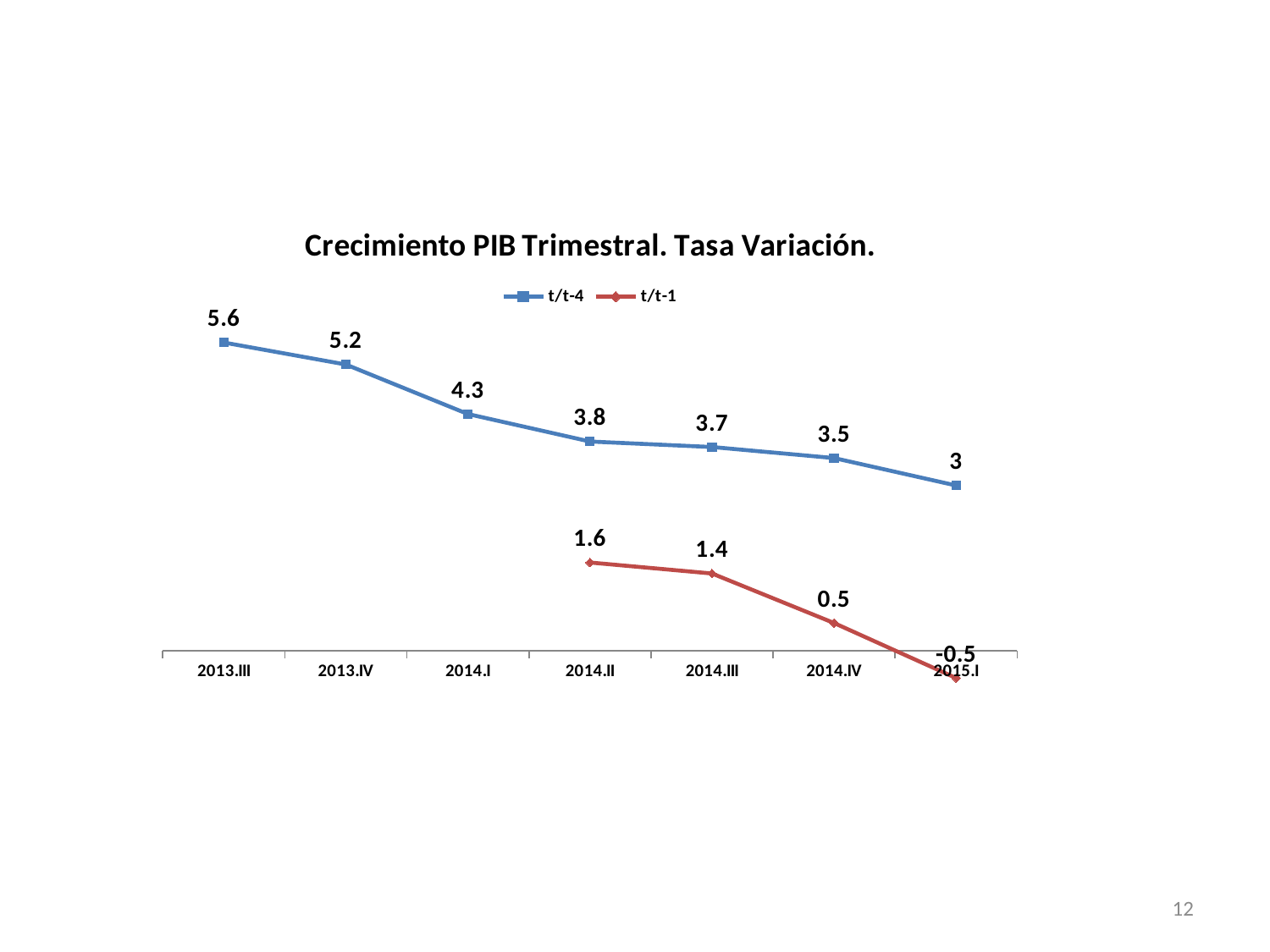
How many quarters are shown on the x axis? 7 Does the t/t-4 series rise or fall from 2013.III to 2015.I? Fall What is the t/t-4 value for 2013.III? 5.6 What is the t/t-1 value for 2015.I? -0.5 What is the t/t-1 value for 2014.IV? 0.5 Which is larger for 2014.II: the t/t-4 value or the t/t-1 value? t/t-4 What kind of chart is this? Line chart Which quarter has the lowest t/t-1 value? 2015.I How many series does the legend list? 2 What is the difference between the t/t-4 values for 2013.III and 2015.I? 2.6 Which quarter has the highest t/t-4 value? 2013.III What is the t/t-4 value for 2015.I? 3